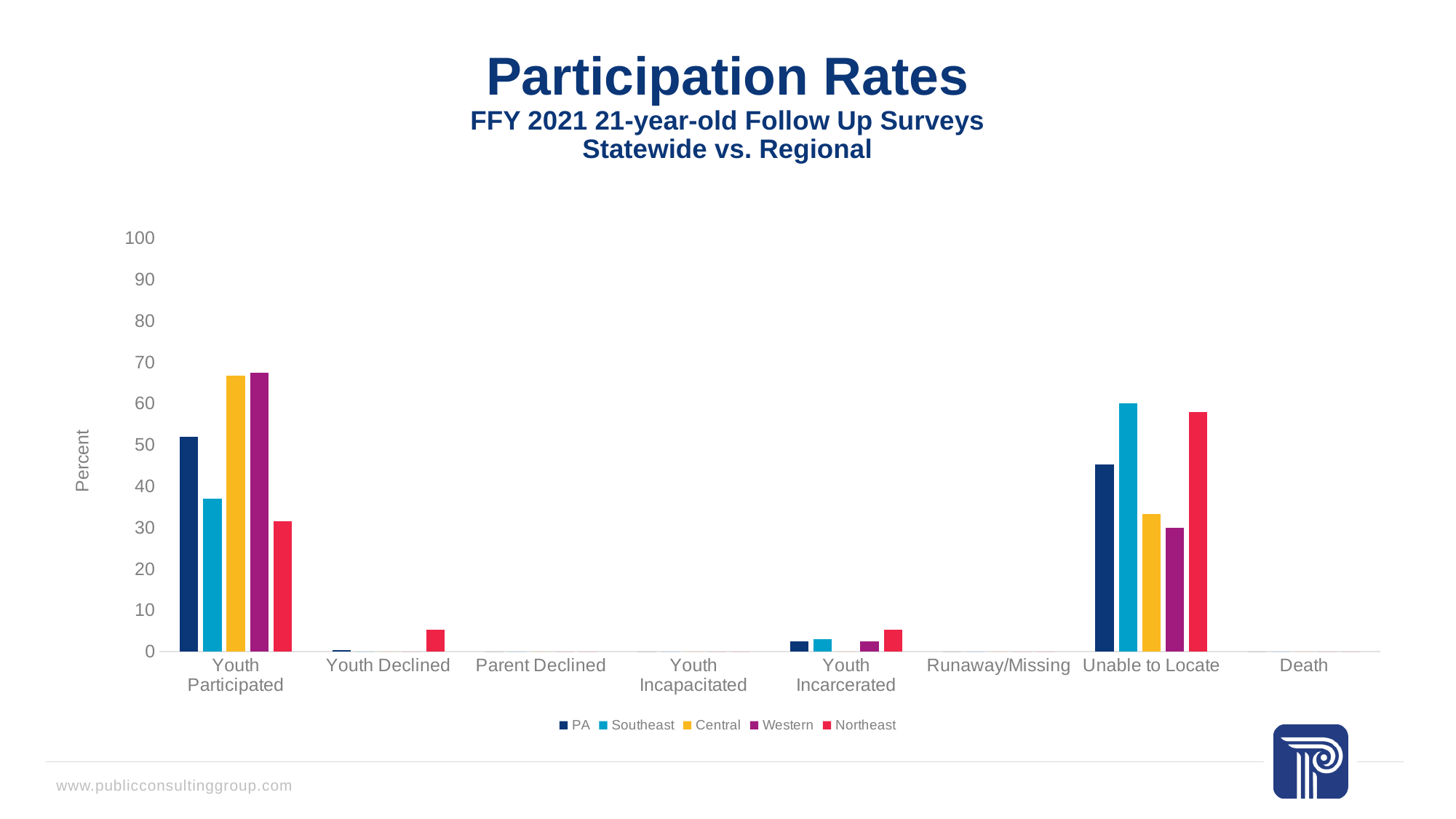
Is the value for Southeast in the Youth Participated category greater or less than 40? less What kind of chart is shown on the slide? bar chart Which is larger for Unable to Locate: PA or Southeast? Southeast How many series does the legend list? 5 Which series has the highest value for Youth Declined? Northeast Is the value for PA in the Unable to Locate category greater or less than 40? greater Is the value for Central in the Youth Participated category greater or less than 60? greater How many categories are shown along the x axis? 8 What is the label on the vertical axis? Percent Which series has the lowest value for Youth Participated? Northeast Which is larger for Youth Participated: PA or Southeast? PA